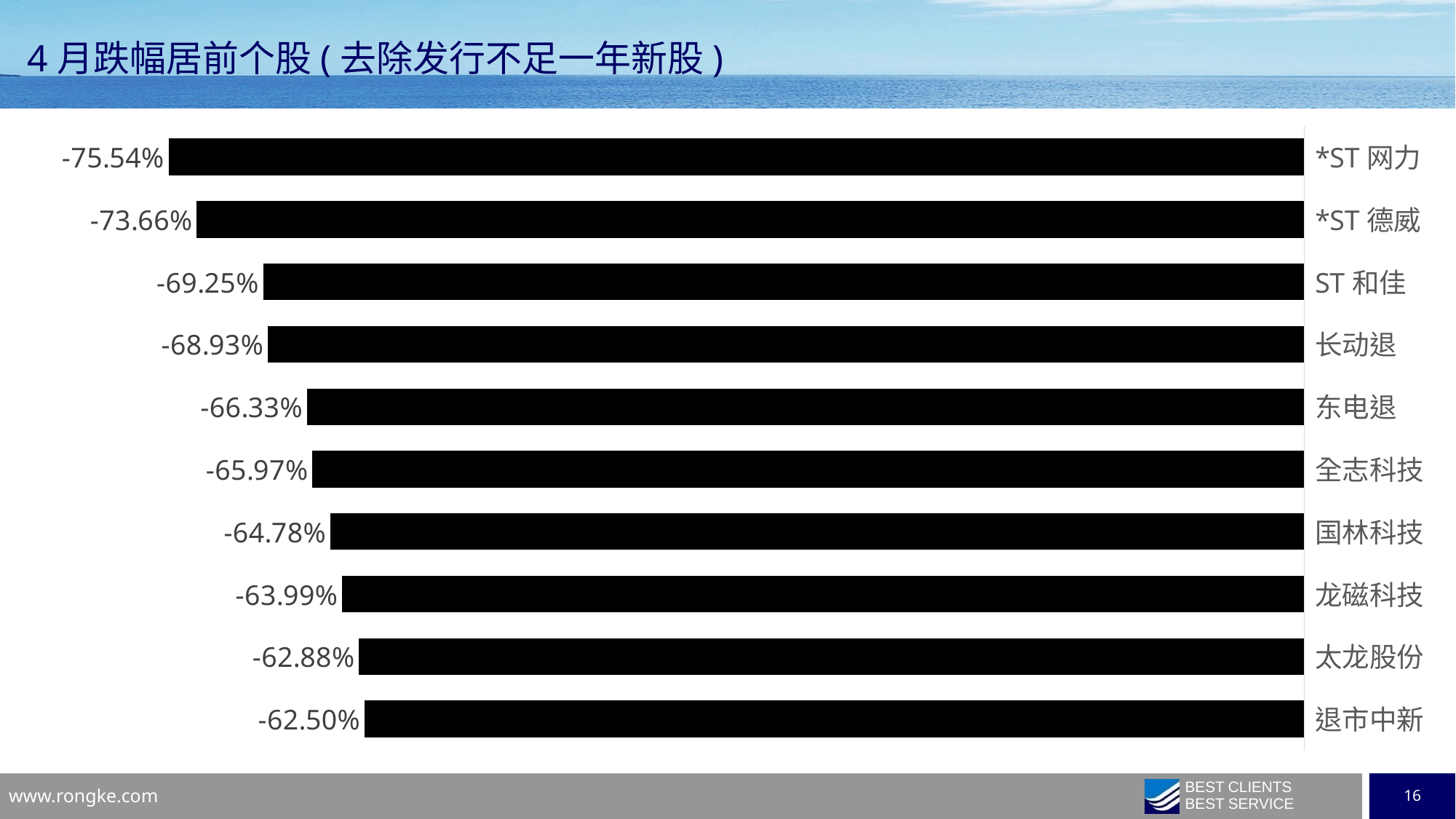
What is the difference between the values for ST 和佳 and 长动退? 0.32% Which has a larger decline, 全志科技 or 国林科技? 全志科技 How many stocks are shown in the chart? 10 What is the value for 退市中新? -62.50% Which stock has the largest decline (lowest value)? *ST 网力 Which stock has the smallest decline (highest value)? 退市中新 What is the difference between the values for *ST 网力 and *ST 德威? 1.88% What is the value for 龙磁科技? -63.99% What kind of chart is shown on the slide? bar chart What is the value for 东电退? -66.33% What is the title of the slide? 4 月跌幅居前个股 ( 去除发行不足一年新股 ) What is the value for *ST 网力? -75.54%